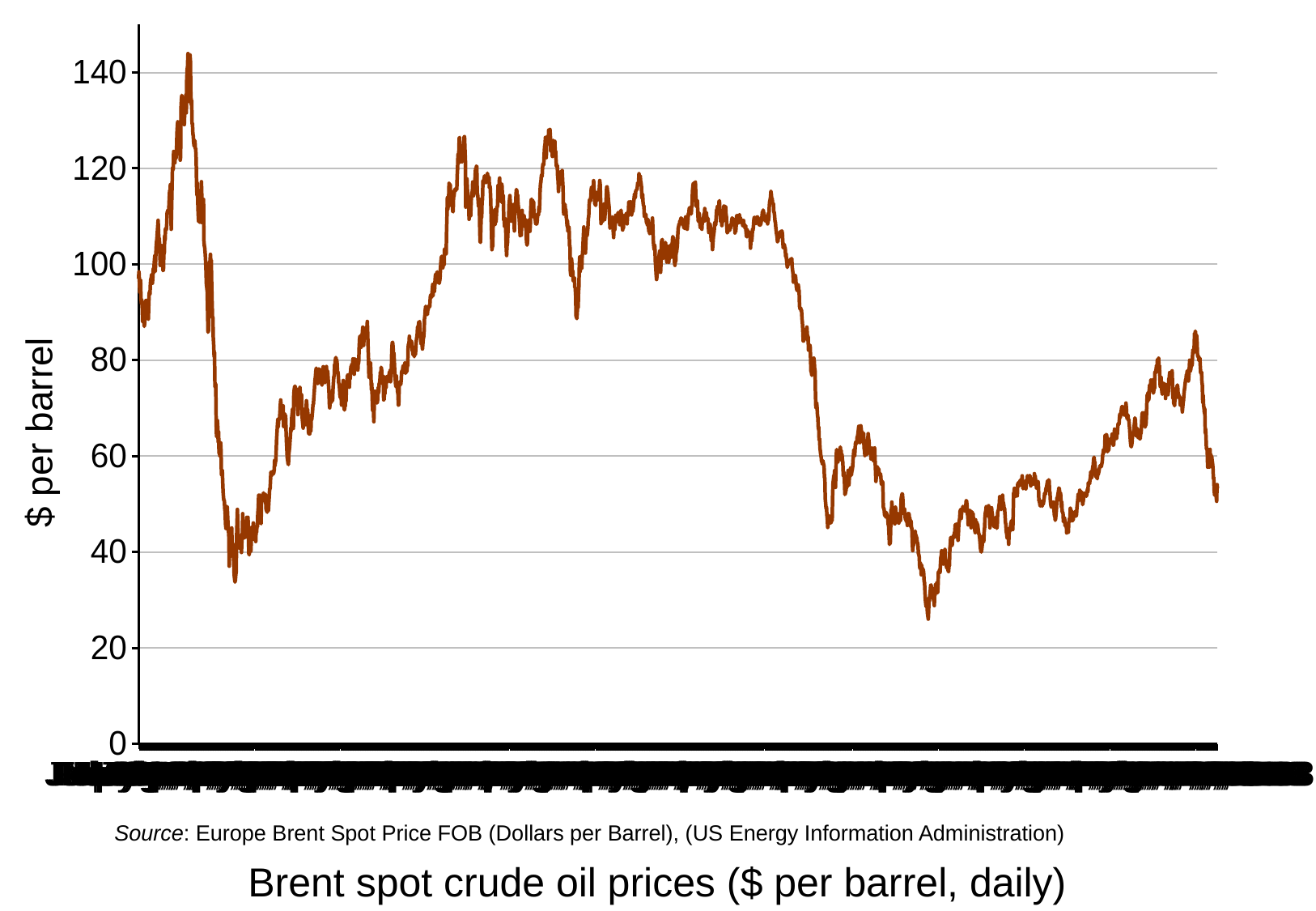
Is the lowest point of the line greater or less than 40? less Does the line end higher or lower than where it starts? lower Is the lowest point of the line greater or less than 20? greater What kind of chart is shown on the slide? Line chart Is the value at the left-hand start of the line greater or less than 80? greater What is the title of the chart? Brent spot crude oil prices ($ per barrel, daily) What is the label on the vertical axis of the chart? $ per barrel How many data series are plotted on the chart? 1 What is the highest tick value shown on the vertical axis? 140